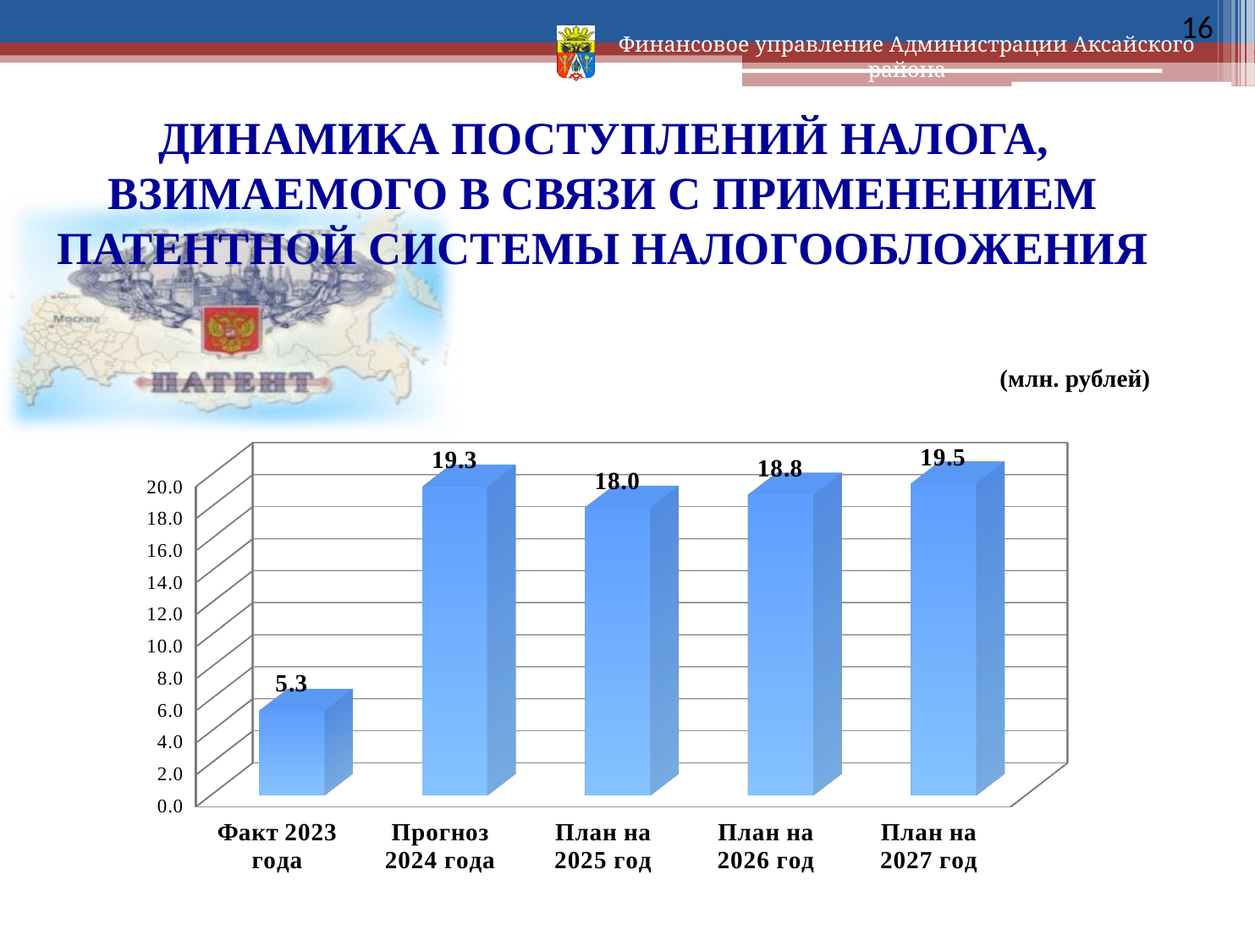
What is the value for План на 2027 год? 19.5 What is the difference between the values for Прогноз 2024 года and Факт 2023 года? 14.0 How many categories are shown on the chart? 5 Which is larger, the value for План на 2026 год or План на 2025 год? План на 2026 год Which category has the highest value? План на 2027 год What is the value for Прогноз 2024 года? 19.3 What kind of chart is shown on the slide? bar chart What unit is indicated for the chart values? млн. рублей What is the value for План на 2025 год? 18.0 Which category has the lowest value? Факт 2023 года What is the value for Факт 2023 года? 5.3 Is the value for План на 2026 год greater or less than 16.0? greater